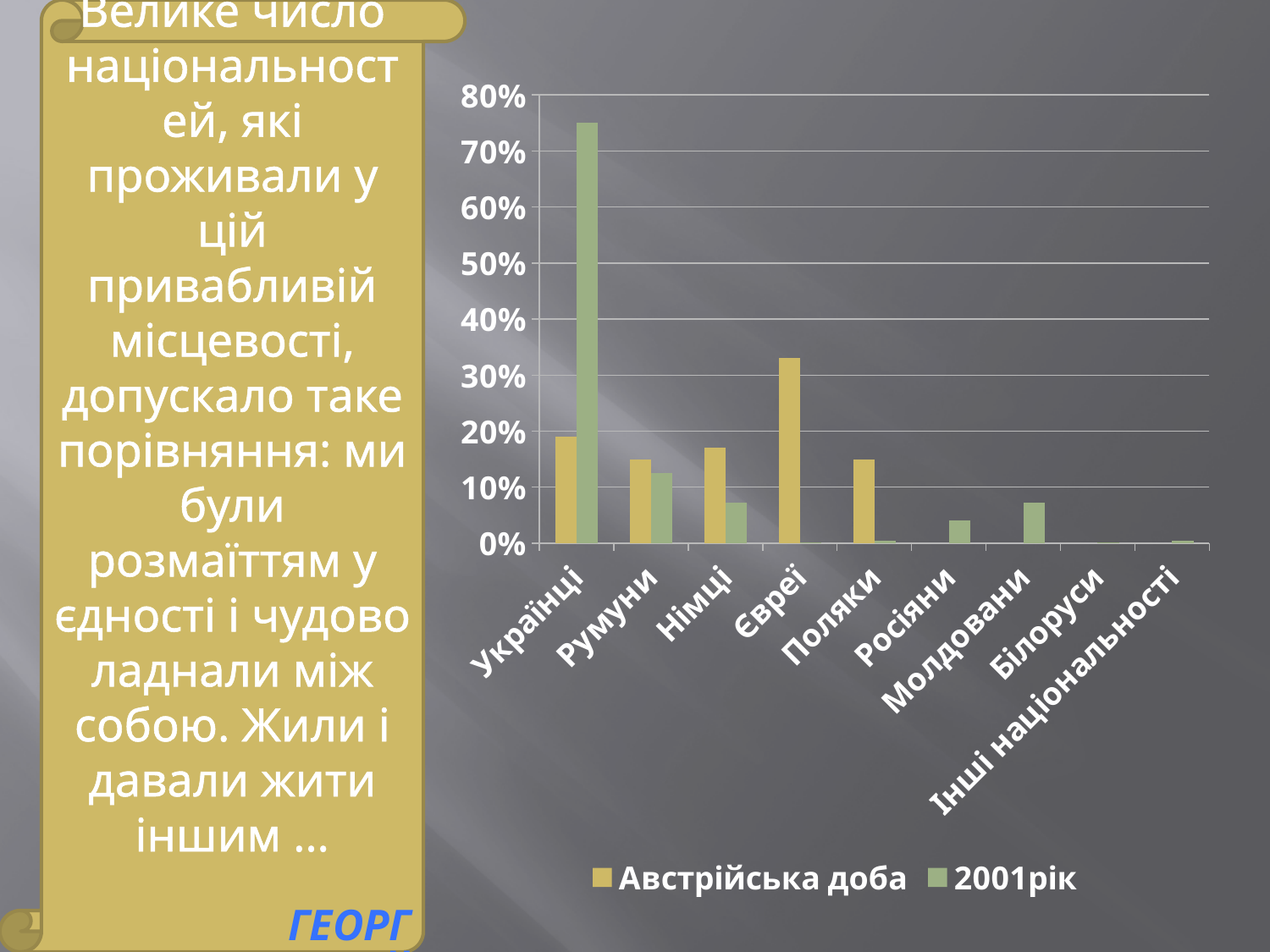
What kind of chart is shown on the slide? bar chart How many categories are shown on the x axis of the chart? 9 Is the 2001рік value for Українці greater or less than 70%? greater For Українці, which series has the larger value: Австрійська доба or 2001рік? 2001рік How many series does the chart's legend list? 2 Which category has the highest value for the Австрійська доба series? Євреї Which category has the highest value for the 2001рік series? Українці What are the two series names listed in the chart's legend? Австрійська доба and 2001рік Is the Австрійська доба value for Євреї greater or less than 30%? greater For Німці, which series has the larger value: Австрійська доба or 2001рік? Австрійська доба Is the Австрійська доба value for Українці greater or less than 20%? less